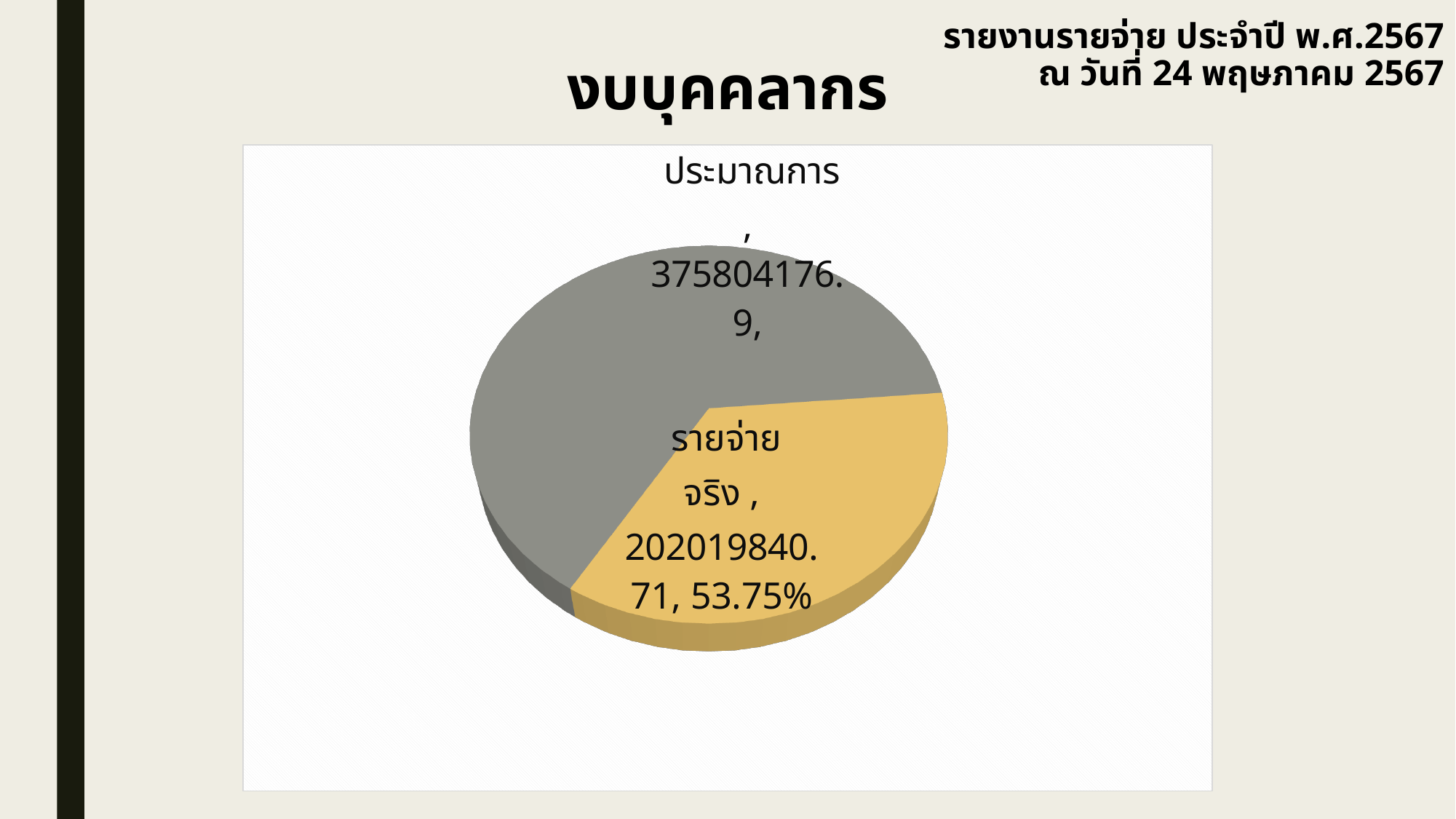
What percentage is printed on the รายจ่ายจริง slice label? 53.75% What value is shown for ประมาณการ in the pie chart? 375804176.9 What colour is the รายจ่ายจริง slice? yellow Which slice of the pie chart is the smallest? รายจ่ายจริง Which is larger, ประมาณการ or รายจ่ายจริง? ประมาณการ How many slices does the pie chart have? 2 What is the total of the two values shown in the pie chart? 577824017.61 What is the difference between the ประมาณการ value and the รายจ่ายจริง value? 173784336.19 What kind of chart is shown on the slide? pie chart What value is shown for รายจ่ายจริง in the pie chart? 202019840.71 Which slice of the pie chart is the largest? ประมาณการ What is the title of the slide above the pie chart? งบบุคลากร